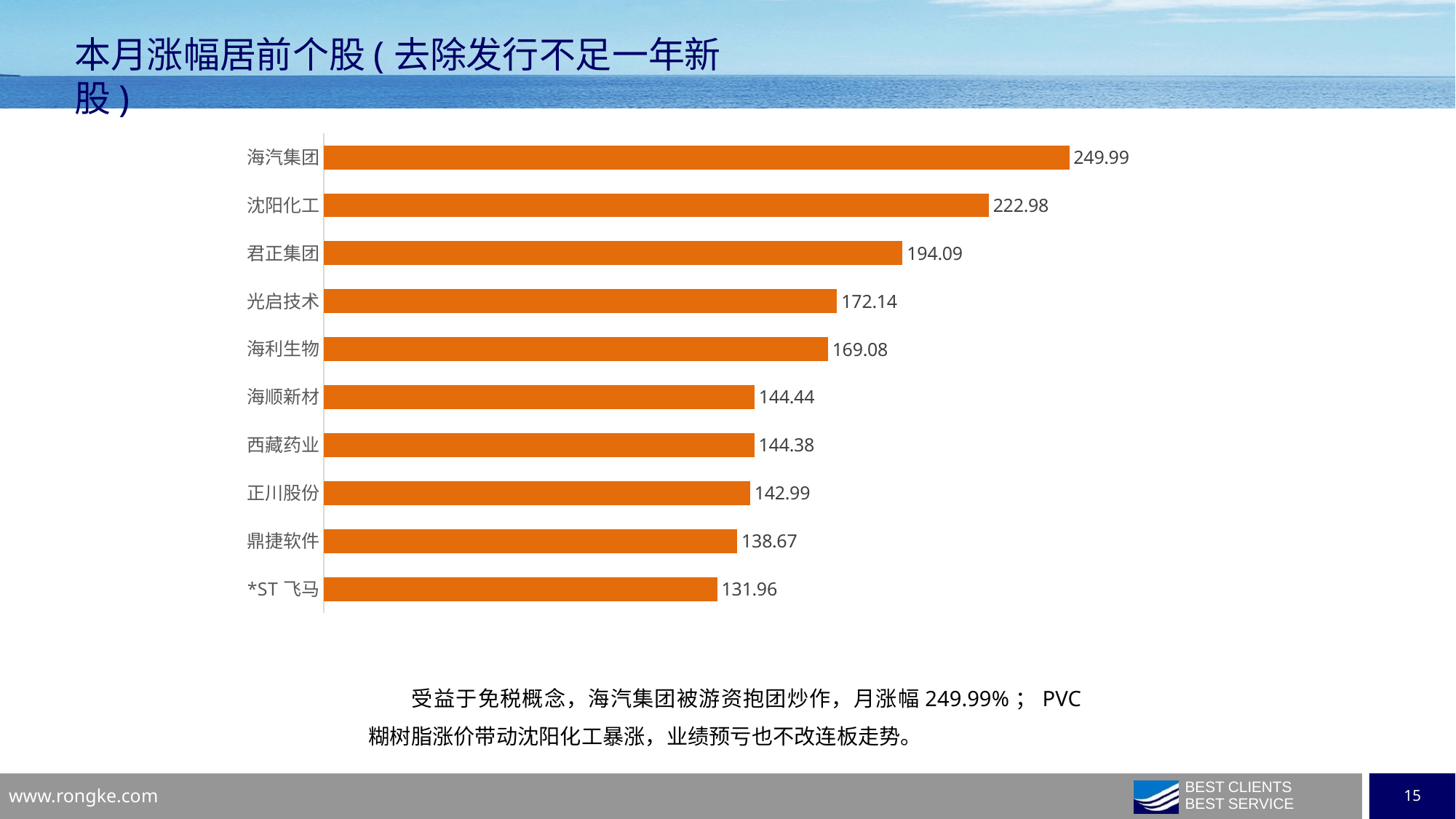
What kind of chart is shown on the slide? Bar chart What colour are the bars in the chart? Orange Which has a larger value, 正川股份 or 海利生物? 海利生物 What is the value shown for 鼎捷软件? 138.67 How many stocks are shown in the chart? 10 What is the difference between the values for 海顺新材 and *ST 飞马? 12.48 Which has a larger value, 君正集团 or 光启技术? 君正集团 What is the value shown for 海汽集团? 249.99 Which stock has the lowest value in the chart? *ST 飞马 What is the value shown for 君正集团? 194.09 What is the difference between the values for 海汽集团 and 沈阳化工? 27.01 Which stock has the highest value in the chart? 海汽集团